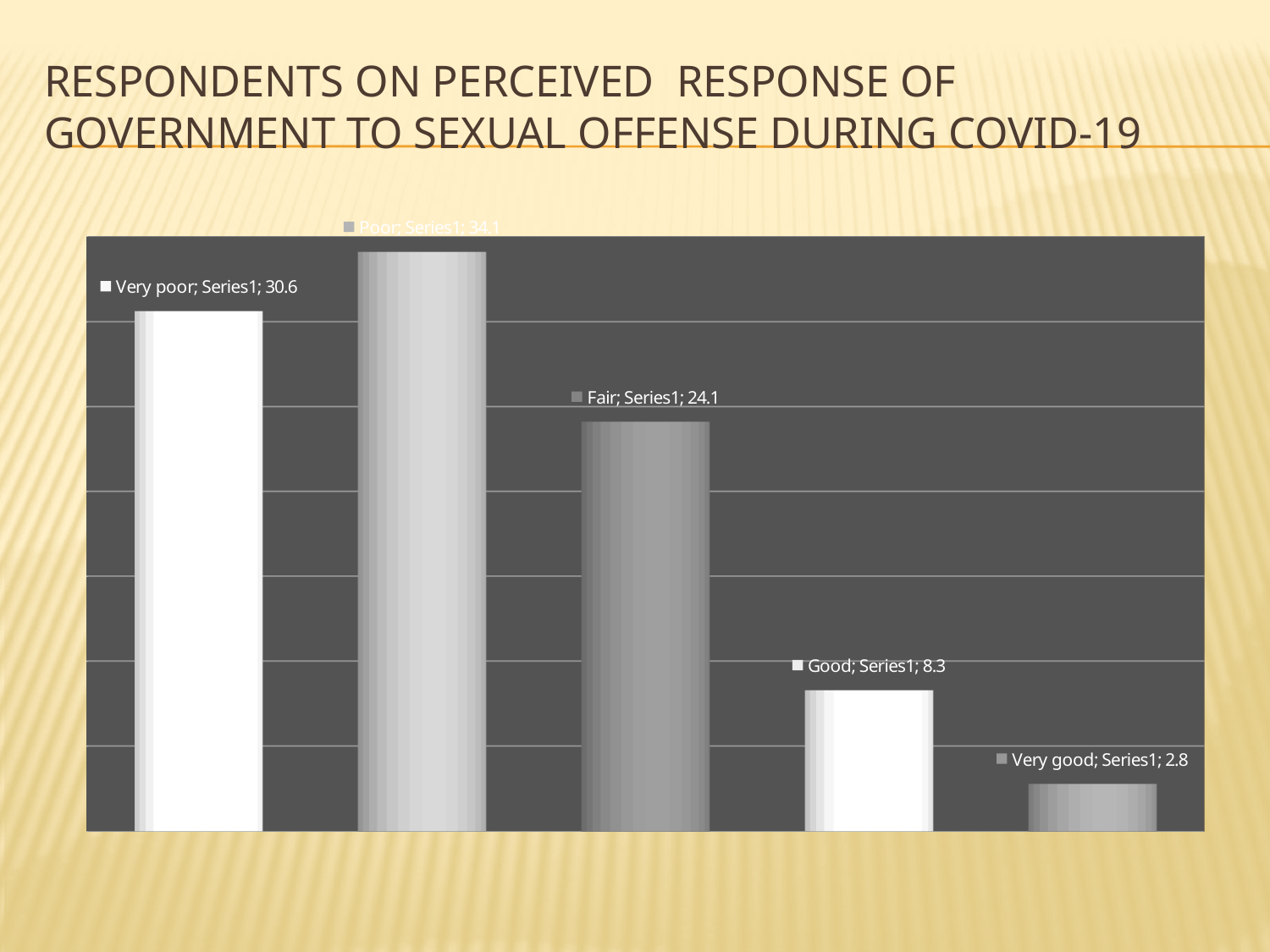
How many categories are shown in the chart? 5 Which category has the lowest value? Very good What is the value for Very good? 2.8 What is the value for Poor? 34.1 What is the difference between the values for Poor and Very poor? 3.5 What is the value for Very poor? 30.6 What is the value for Fair? 24.1 What is the value for Good? 8.3 What is the difference between the values for Fair and Good? 15.8 What kind of chart is shown on the slide? Bar chart Which category has the highest value? Poor Which is larger, the value for Fair or the value for Good? Fair